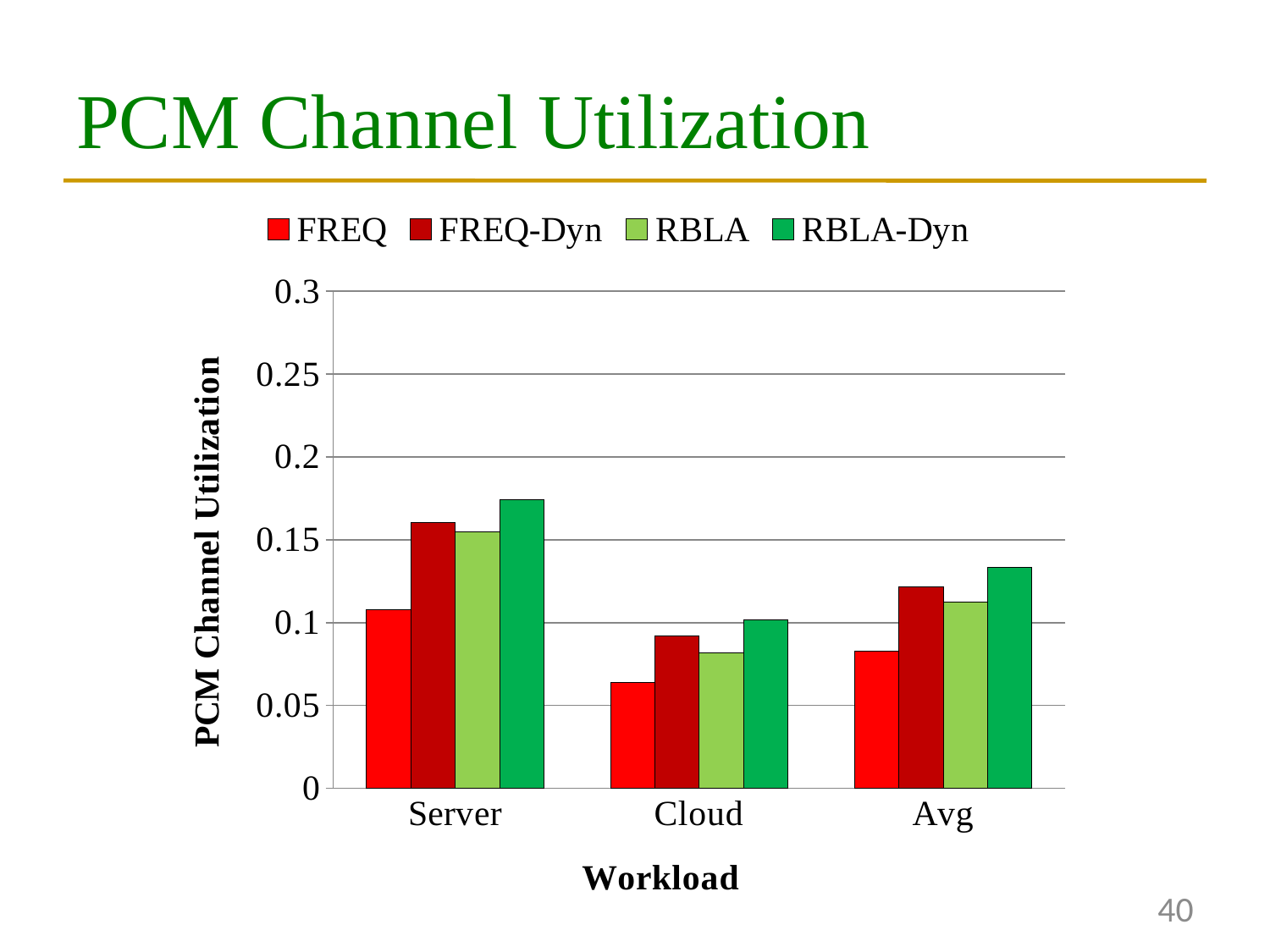
Which workload has the highest RBLA-Dyn bar? Server Which workload has the lowest FREQ bar? Cloud How many series does the legend list? 4 Which series has the highest PCM channel utilization for the Server workload? RBLA-Dyn What is the label of the y axis? PCM Channel Utilization Is the value for RBLA-Dyn on the Avg workload greater or less than 0.1? greater For the Avg workload, which is larger: FREQ-Dyn or RBLA? FREQ-Dyn Which series has the lowest PCM channel utilization for the Cloud workload? FREQ Is the value for RBLA-Dyn on the Server workload greater or less than 0.15? greater What kind of chart is shown on the slide? bar chart How many workload categories are shown on the x axis? 3 Is the value for FREQ on the Cloud workload greater or less than 0.1? less